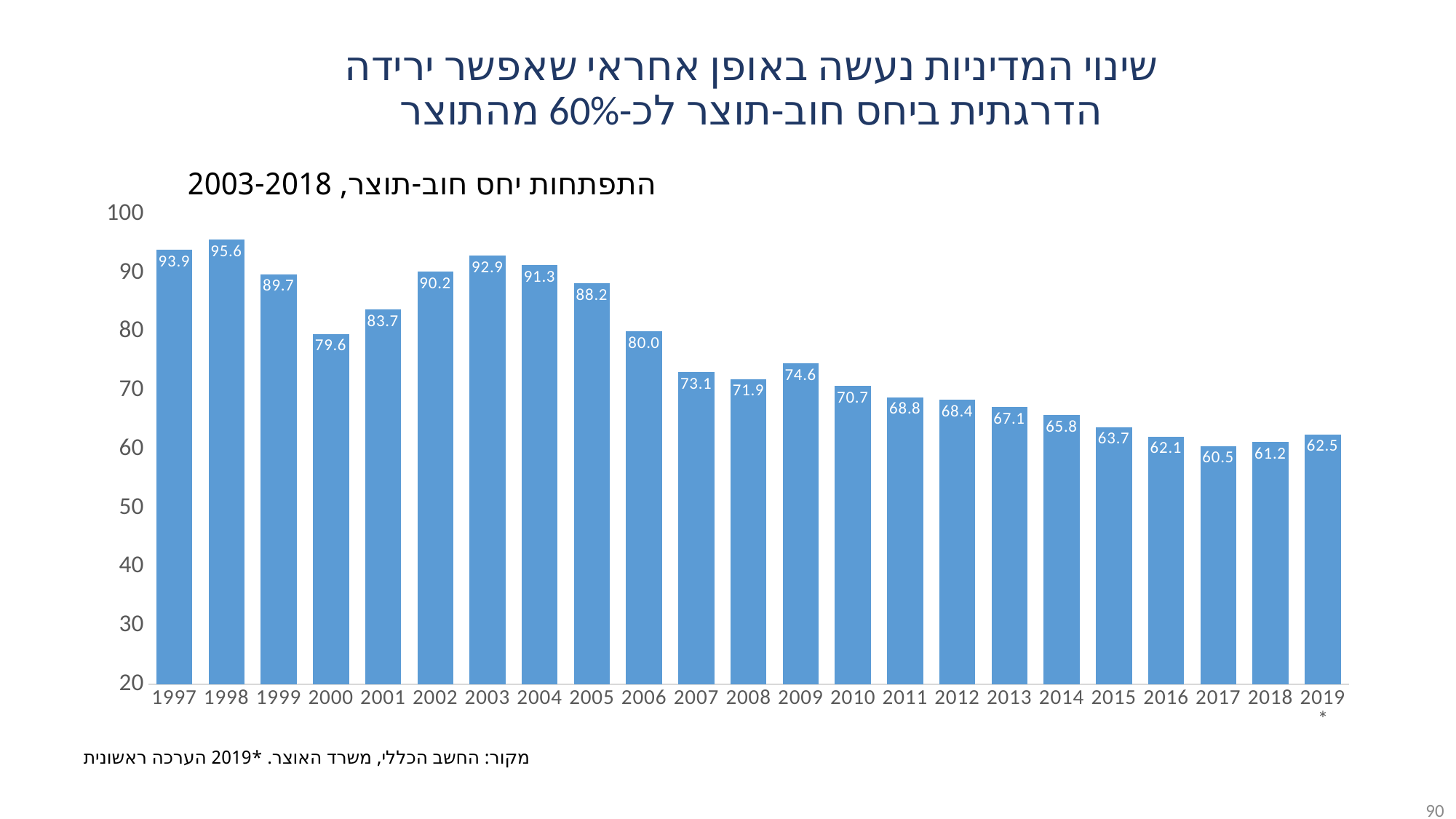
What kind of chart is shown on the slide? Bar chart What is the debt-to-GDP ratio value shown for 2005? 88.2 What is the lowest value printed on the y axis? 20 Which year has the lowest value in the chart? 2017 Is the value for 2009 greater or less than 70? greater Which year has the highest value in the chart? 1998 What is the value shown for 2019? 62.5 What is the difference between the values for 2003 and 2004? 1.6 Which year has a larger value, 2000 or 2001? 2001 How many years are shown on the x axis? 23 What is the difference between the values for 1998 and 2017? 35.1 Do the values generally rise or fall from 1997 to 2019? Fall